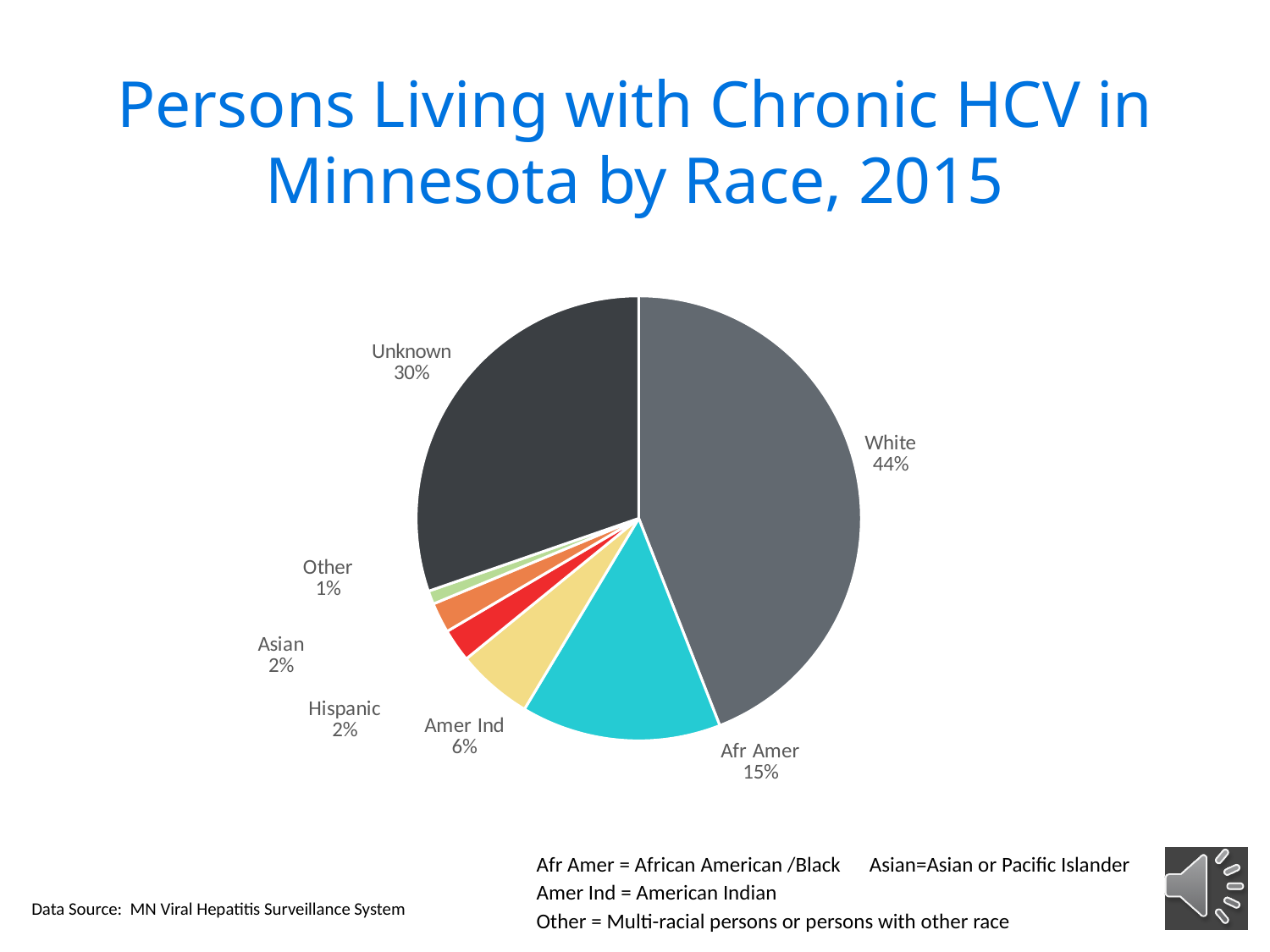
Which is larger, the Afr Amer slice or the Amer Ind slice? Afr Amer What is the value for Amer Ind? 6% What is the title of the chart on the slide? Persons Living with Chronic HCV in Minnesota by Race, 2015 What percentage is shown for Afr Amer? 15% What is the difference in percentage points between White and Unknown? 14 What is the data source cited on the slide? MN Viral Hepatitis Surveillance System What is the value shown for Unknown? 30% Which race category has the largest slice of the pie? White What kind of chart is shown on the slide? Pie chart How many categories are shown in the pie chart? 7 Which category has the smallest slice of the pie? Other What share of the pie does the White slice represent? 44%